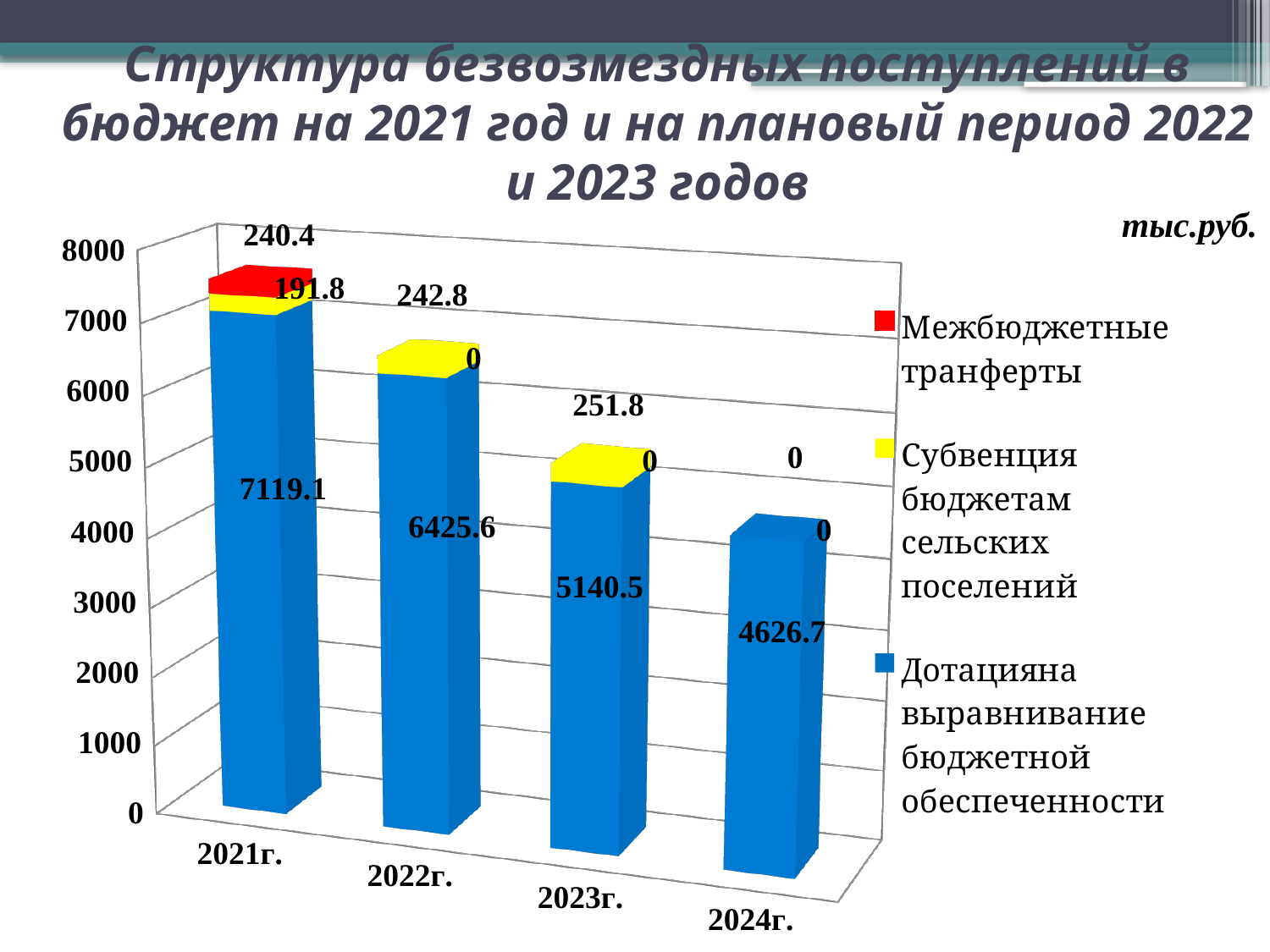
What is the value of Межбюджетные трансферты for 2021г.? 191.8 What is the total of the stacked bar for 2022г.? 6668.4 Does the Дотация на выравнивание бюджетной обеспеченности value rise or fall from 2021г. to 2024г.? fall Which year has the highest value of Дотация на выравнивание бюджетной обеспеченности? 2021г. Which is larger: the Субвенция бюджетам сельских поселений value for 2022г. or for 2023г.? 2023г. What is the value of Дотация на выравнивание бюджетной обеспеченности for 2024г.? 4626.7 How many years are shown on the x axis? 4 How many series does the legend list? 3 Which year has the lowest value of Дотация на выравнивание бюджетной обеспеченности? 2024г. What is the difference between the Дотация на выравнивание бюджетной обеспеченности values for 2021г. and 2022г.? 693.5 What is the value of Дотация на выравнивание бюджетной обеспеченности for 2021г.? 7119.1 What is the value of Субвенция бюджетам сельских поселений for 2023г.? 251.8